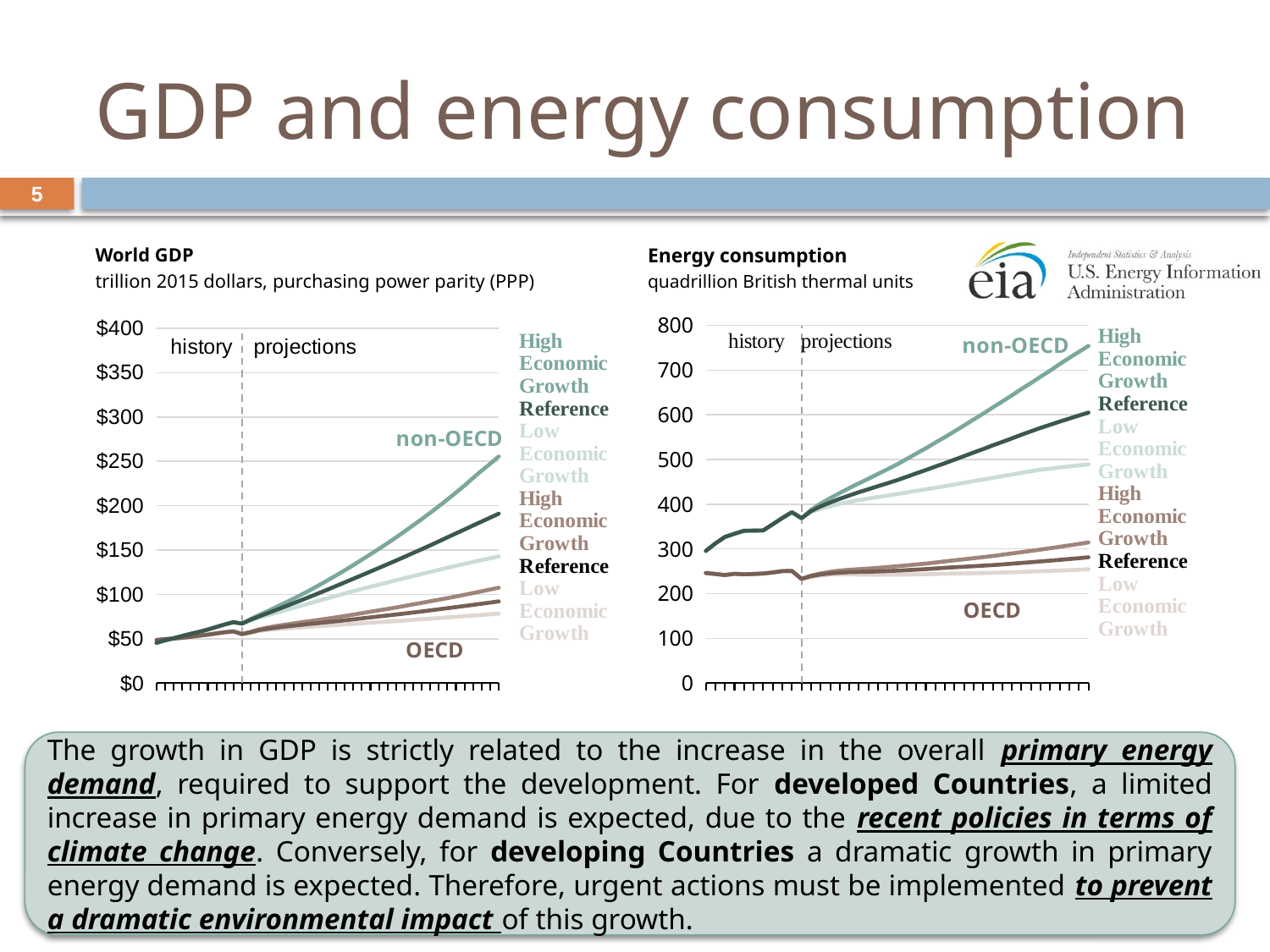
What unit is used on the World GDP chart? trillion 2015 dollars, purchasing power parity (PPP) In the Energy consumption chart, is the final projected value for non-OECD High Economic Growth greater or less than 700? greater In the World GDP chart, how many series does the legend list? 6 What kind of chart is the Energy consumption chart? line chart In the Energy consumption chart, how many series does the legend list? 6 What kind of chart is the World GDP chart? line chart In the World GDP chart, is the final projected value for non-OECD High Economic Growth greater or less than $200? greater In the World GDP chart, do the non-OECD High Economic Growth values rise or fall over the projection period? rise What unit is used on the Energy consumption chart? quadrillion British thermal units In the Energy consumption chart, at the end of the projections, which is larger: the non-OECD Reference value or the OECD Reference value? non-OECD Reference In the Energy consumption chart, is the final projected value for OECD Low Economic Growth greater or less than 300? less